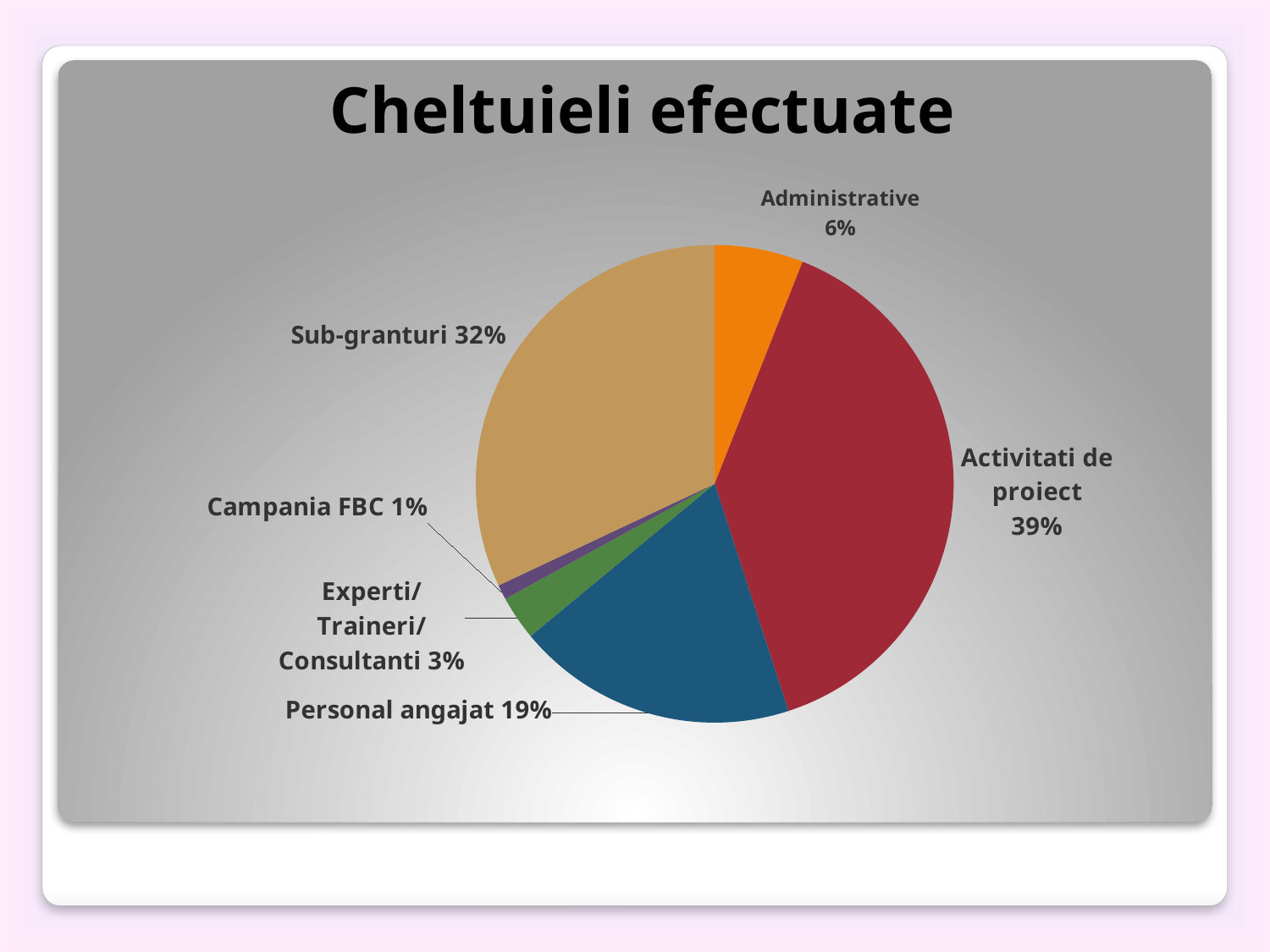
What type of chart is shown on the slide? pie chart What is the value for Experti/Traineri/Consultanti? 3% What is the value for Personal angajat? 19% What is the value for Administrative? 6% What share of the pie is Activitati de proiect? 39% What is the title of the chart? Cheltuieli efectuate What share of the pie is Sub-granturi? 32% Which is larger, Personal angajat or Administrative? Personal angajat Which category has the largest share of the pie? Activitati de proiect Which category has the smallest share of the pie? Campania FBC What is the difference between the shares of Activitati de proiect and Sub-granturi? 7% How many categories are shown in the pie chart? 6